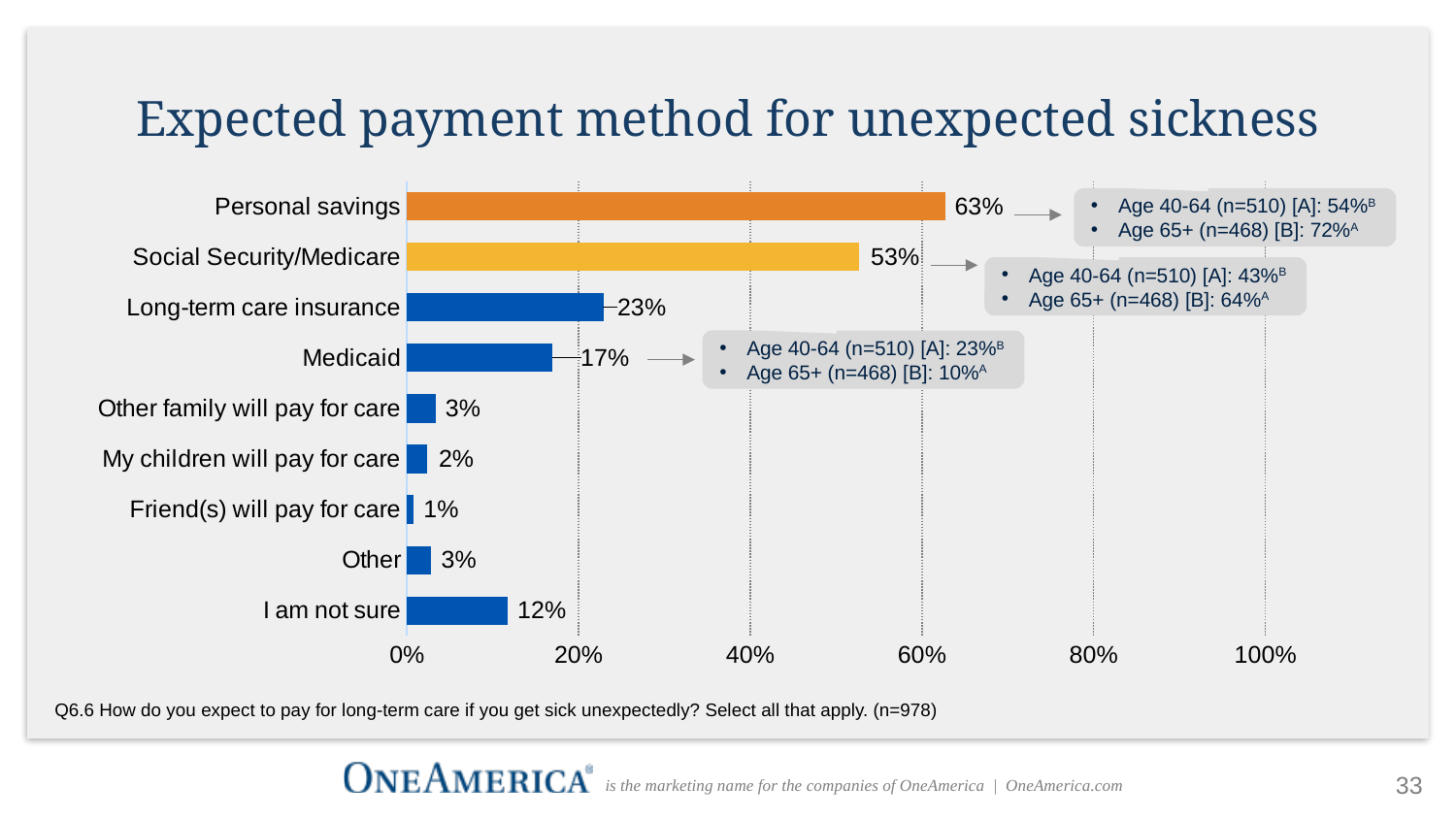
What is the title of the chart? Expected payment method for unexpected sickness According to the callout, what percentage of the Age 65+ group expects to pay with personal savings? 72% What percentage of respondents said 'I am not sure'? 12% What is the value for Social Security/Medicare? 53% Which is larger, Medicaid or Long-term care insurance? Long-term care insurance How many payment method categories are shown in the chart? 9 What percentage of respondents expect to pay with personal savings? 63% What is the value for Long-term care insurance? 23% What kind of chart is shown on the slide? Bar chart Which payment method has the lowest percentage? Friend(s) will pay for care Which payment method has the highest percentage? Personal savings What is the difference between Personal savings and Social Security/Medicare? 10%